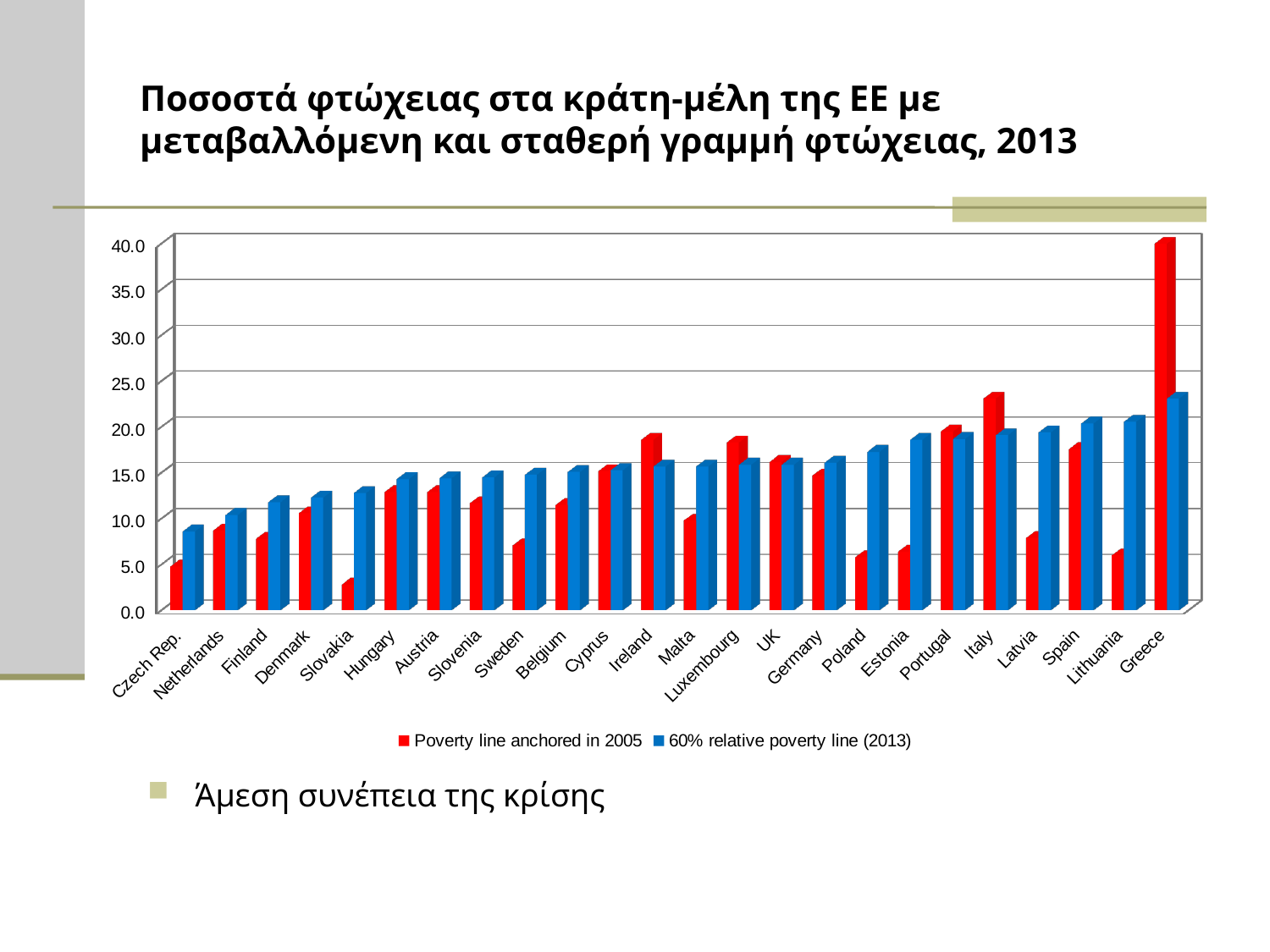
Is the 'Poverty line anchored in 2005' value for Italy greater or less than 20.0? greater How many series does the legend list? 2 Do the values of the '60% relative poverty line (2013)' series generally rise or fall from left to right along the x axis? rise Which country has the lowest value for the '60% relative poverty line (2013)' series? Czech Rep. What kind of chart is shown on the slide? bar chart For Ireland, which series has the larger value: 'Poverty line anchored in 2005' or '60% relative poverty line (2013)'? Poverty line anchored in 2005 Is the 'Poverty line anchored in 2005' value for Greece greater or less than 35.0? greater Which country has the lowest value for the 'Poverty line anchored in 2005' series? Slovakia Which country has the highest value for the 'Poverty line anchored in 2005' series? Greece Is the '60% relative poverty line (2013)' value for Czech Rep. greater or less than 10.0? less How many countries are shown on the x axis? 24 For Poland, which series has the larger value: 'Poverty line anchored in 2005' or '60% relative poverty line (2013)'? 60% relative poverty line (2013)